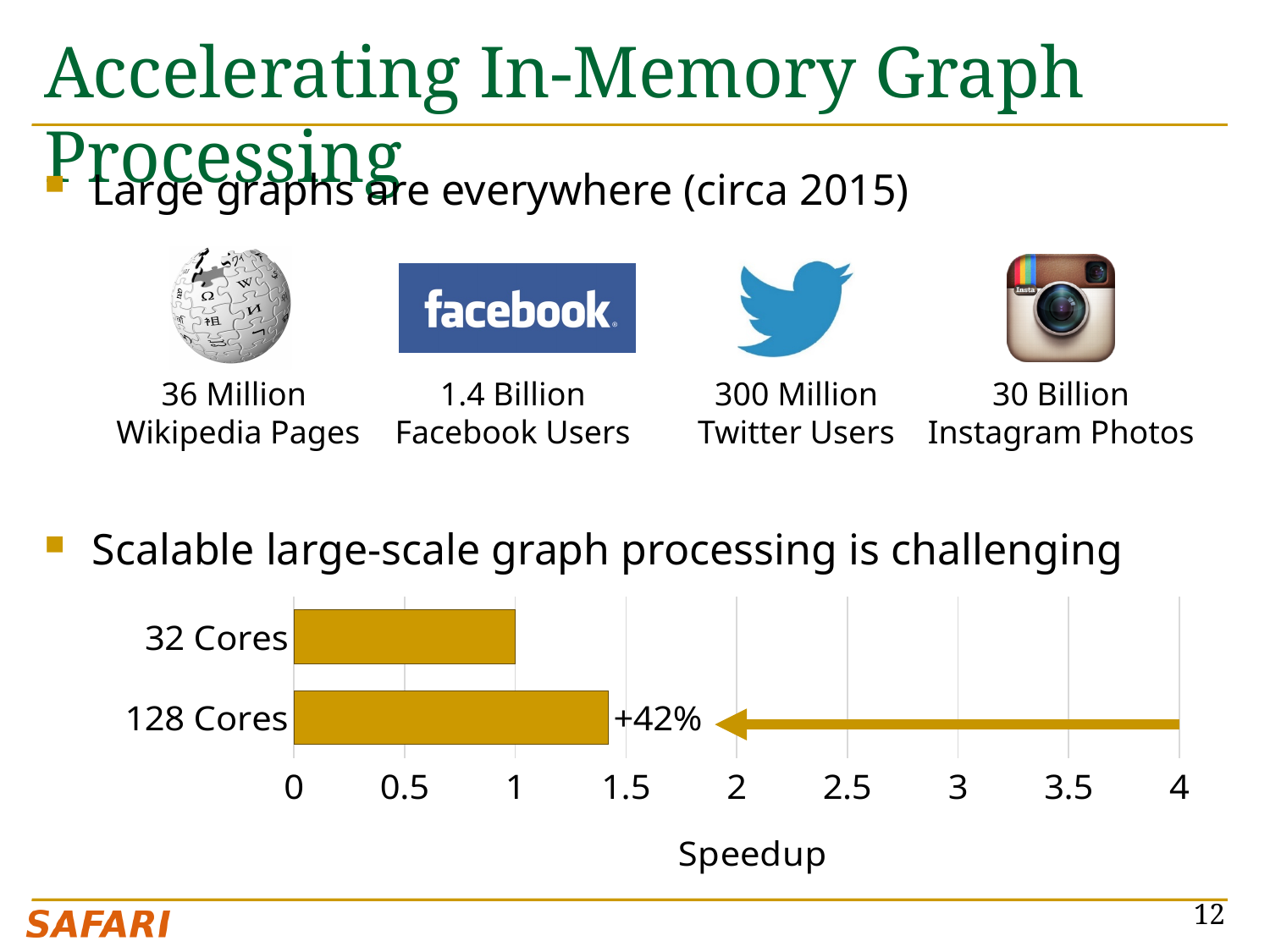
What is the speedup value for 32 Cores? 1 Is the speedup for 128 Cores greater or less than 1? greater Is the speedup for 128 Cores greater or less than 1.5? less What is the maximum value shown on the x axis of the bar chart? 4 What kind of chart is shown on the slide? bar chart Is the speedup for 128 Cores greater or less than 2? less What is the title of the x axis of the bar chart? Speedup Which category has the higher speedup, 32 Cores or 128 Cores? 128 Cores How many categories does the bar chart show? 2 What percentage annotation is printed next to the 128 Cores bar? +42% Which category has the lowest speedup? 32 Cores Which category has the highest speedup? 128 Cores